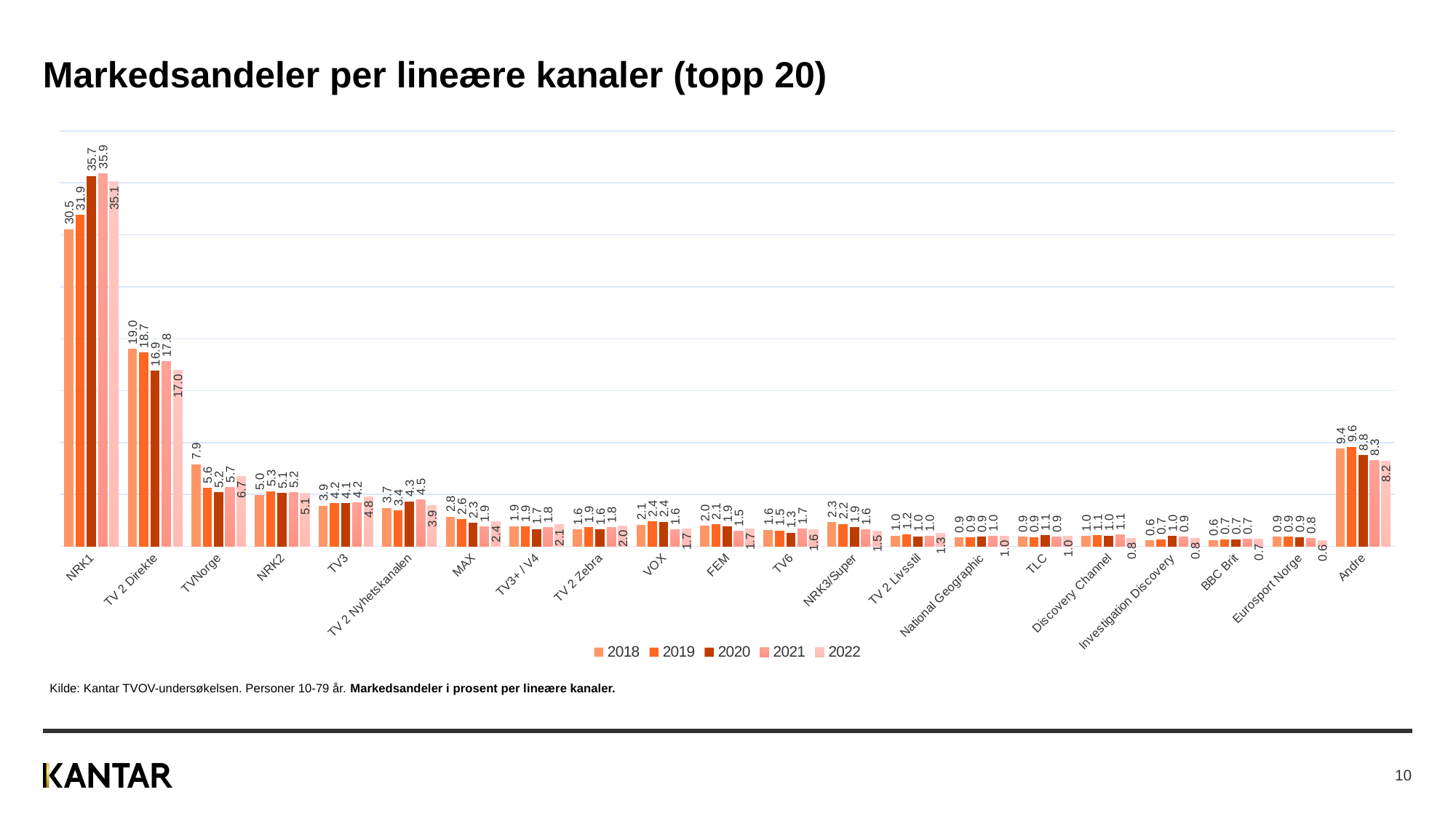
Which channel has the lowest value in 2022? Eurosport Norge Which is larger for TV3: the 2018 value or the 2022 value? 2022 What kind of chart is shown on the slide? Bar chart What is the title of the chart? Markedsandeler per lineære kanaler (topp 20) What is the difference between the 2018 and 2022 values for TV 2 Direkte? 2.0 What is the value for TVNorge in 2022? 6.7 How many series does the legend list? 5 What is the value for TV 2 Direkte in 2018? 19.0 Which channel has the highest value in 2021? NRK1 How many categories are shown on the x axis? 21 What is the value for NRK1 in 2022? 35.1 What is the value for Andre in 2020? 8.8